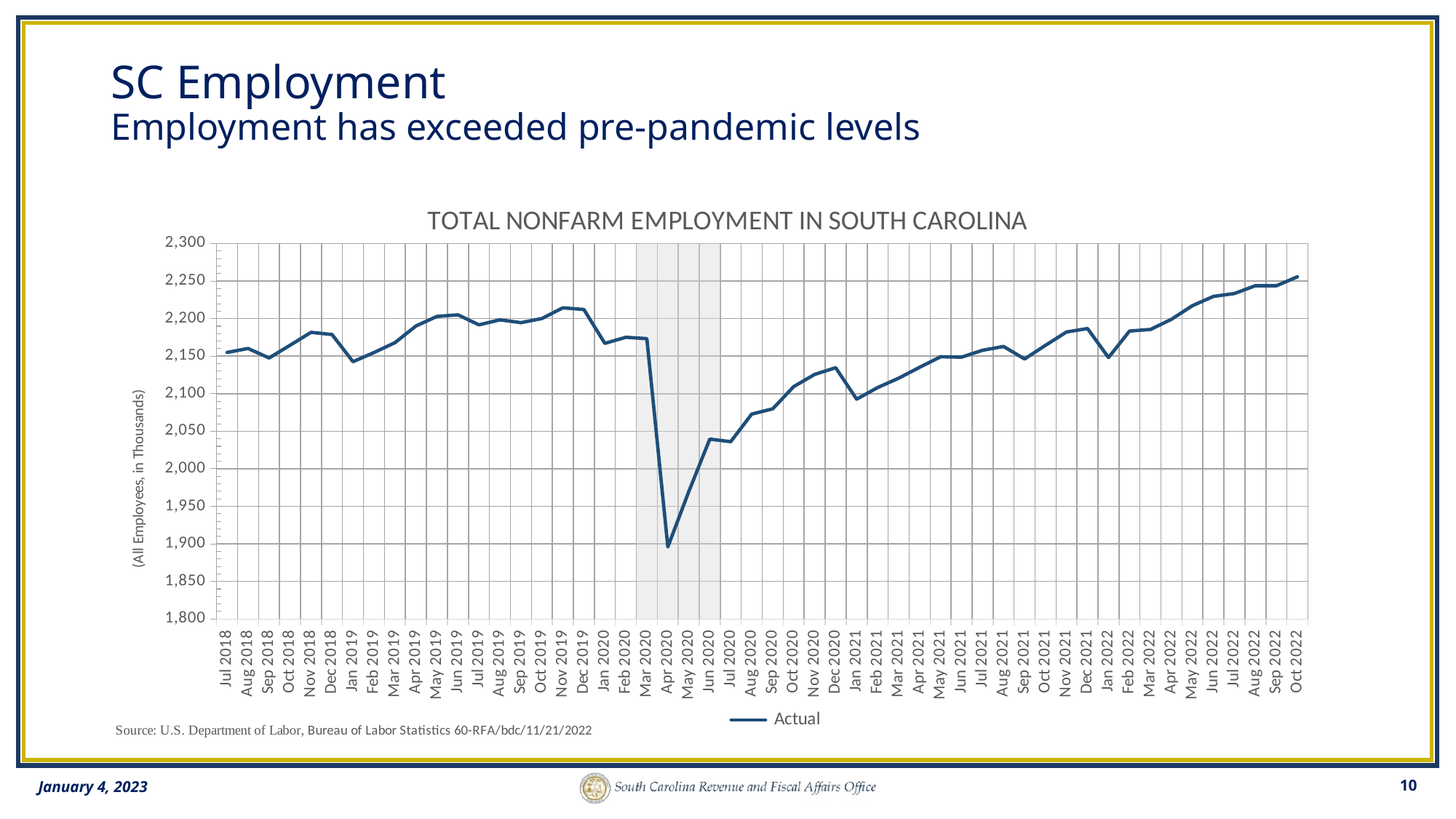
Is the value for Oct 2022 greater or less than 2,200? greater Is the value for Apr 2020 greater or less than 1,950? less What is the title of the chart? TOTAL NONFARM EMPLOYMENT IN SOUTH CAROLINA How many series does the legend list? 1 What is the name of the series shown in the legend? Actual How many monthly data points are plotted on the chart, from Jul 2018 to Oct 2022? 52 In which month does the employment line reach its highest point? Oct 2022 In which month does the employment line reach its lowest point? Apr 2020 Which is larger, the value for Oct 2022 or the value for Nov 2019? Oct 2022 What kind of chart is shown on the slide? line chart Does the employment line generally rise or fall from Apr 2020 to Oct 2022? rise Is the value for Jul 2020 greater or less than 2,050? less